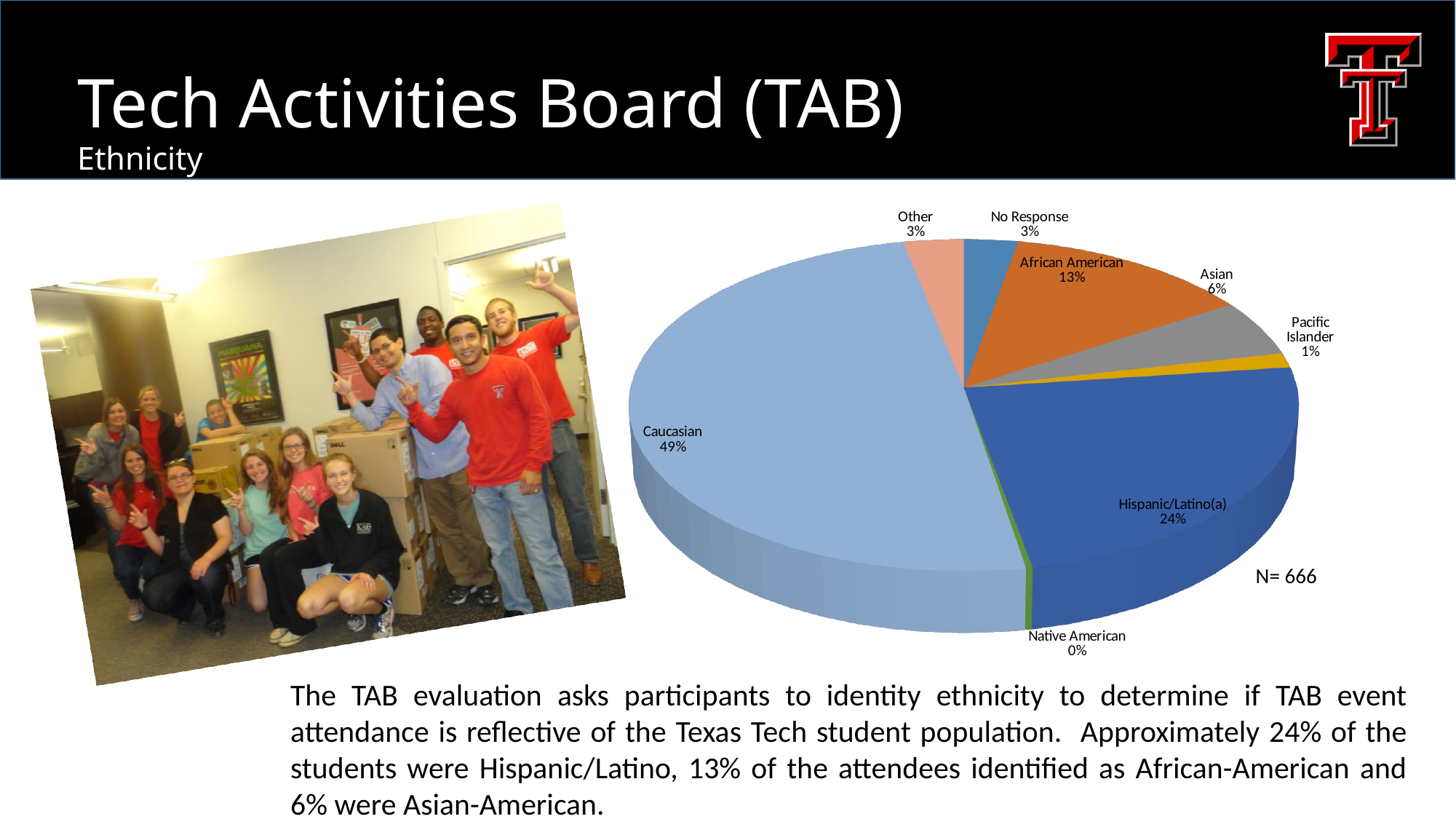
What is the difference in percentage points between Caucasian and Hispanic/Latino(a)? 25 How many categories are shown in the pie chart? 8 What percentage of the pie is Caucasian? 49% Which category has the largest share of the pie? Caucasian What percentage of the pie is African American? 13% What percentage of the pie is Hispanic/Latino(a)? 24% What kind of chart is shown on the slide? pie chart What percentage of the pie is Pacific Islander? 1% What percentage of the pie is Other? 3% Which category has the smallest share of the pie? Native American Which is larger, the share for Asian or the share for African American? African American What is the sample size (N) shown next to the pie chart? N= 666